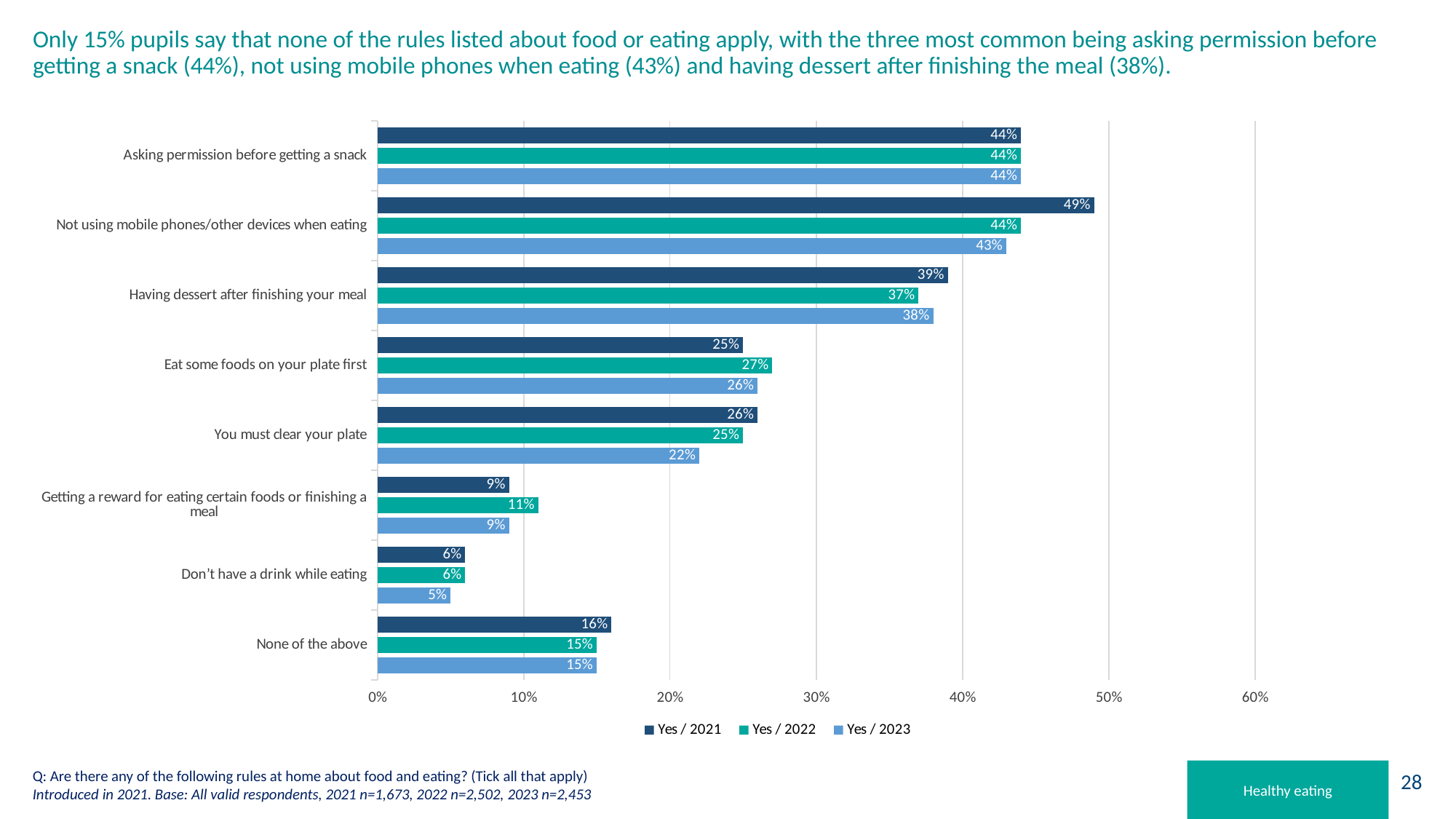
How many categories are shown on the chart? 8 What is the Yes / 2022 value for 'Getting a reward for eating certain foods or finishing a meal'? 11% What is the Yes / 2023 value for 'None of the above'? 15% What is the Yes / 2022 value for 'Eat some foods on your plate first'? 27% What kind of chart is shown on the slide? Bar chart Which category has the highest Yes / 2021 value? Not using mobile phones/other devices when eating How many series does the legend list? 3 Which category has the lowest Yes / 2023 value? Don't have a drink while eating What is the Yes / 2023 value for 'Not using mobile phones/other devices when eating'? 43% What is the difference between the Yes / 2021 and Yes / 2023 values for 'Not using mobile phones/other devices when eating'? 6 percentage points Which is larger for 'You must clear your plate': the Yes / 2021 value or the Yes / 2023 value? Yes / 2021 What is the Yes / 2021 value for 'Not using mobile phones/other devices when eating'? 49%